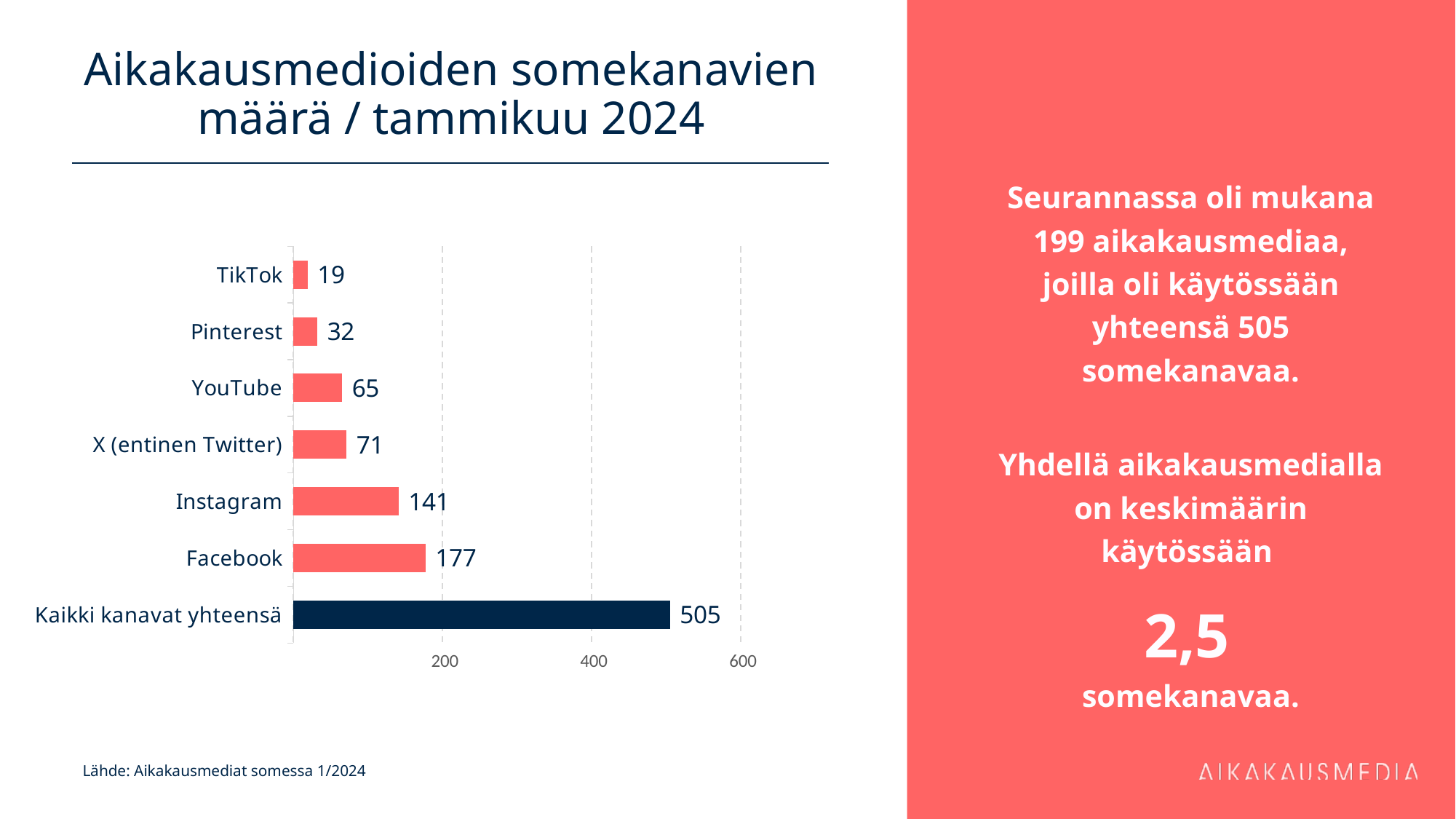
What is the value for X (entinen Twitter)? 71 What kind of chart is shown on the slide? bar chart What is the value for Kaikki kanavat yhteensä? 505 How many bars are shown in the chart? 7 What is the value for TikTok? 19 What is the title of the chart? Aikakausmedioiden somekanavien määrä / tammikuu 2024 Which is larger, the value for YouTube or the value for Pinterest? YouTube Is the value for Instagram greater or less than 200? less What is the value for Facebook? 177 Which individual channel (excluding the total bar) has the highest value? Facebook What is the difference between the values for Facebook and Instagram? 36 Which category has the lowest value? TikTok